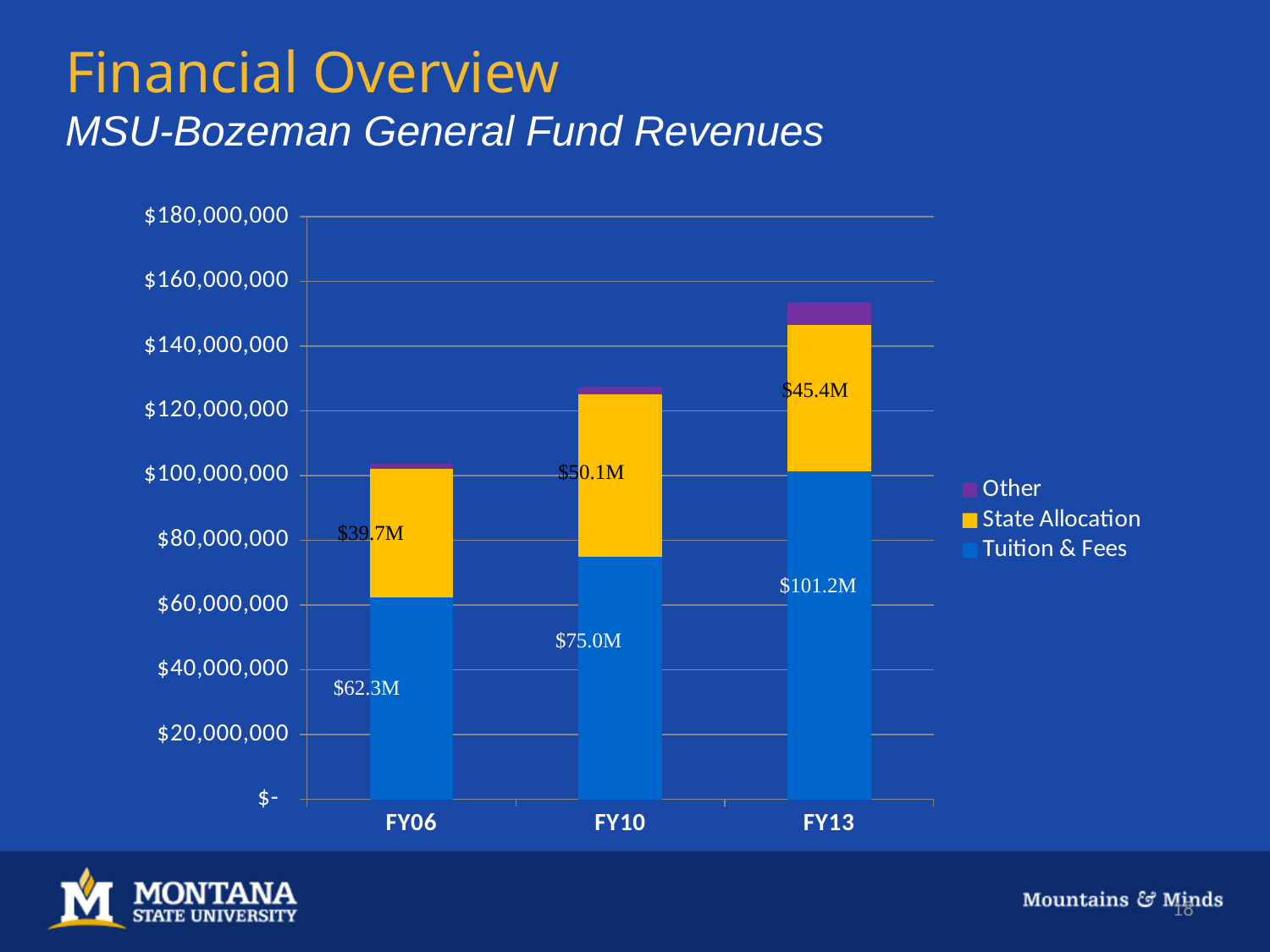
Do the Tuition & Fees values rise or fall from FY06 to FY13? Rise Which is larger: the State Allocation for FY13 or the State Allocation for FY06? FY13 What is the Tuition & Fees value for FY06? $62.3M How many fiscal years are shown on the x axis? 3 Is the total height of the FY13 stacked bar greater or less than $140,000,000? greater Which fiscal year has the highest State Allocation value? FY10 What is the Tuition & Fees value for FY13? $101.2M Which fiscal year has the lowest Tuition & Fees value? FY06 How many series does the legend list? 3 What is the State Allocation value for FY10? $50.1M What is the difference between the Tuition & Fees values for FY13 and FY06? $38.9M What kind of chart is shown on the slide? Stacked bar chart